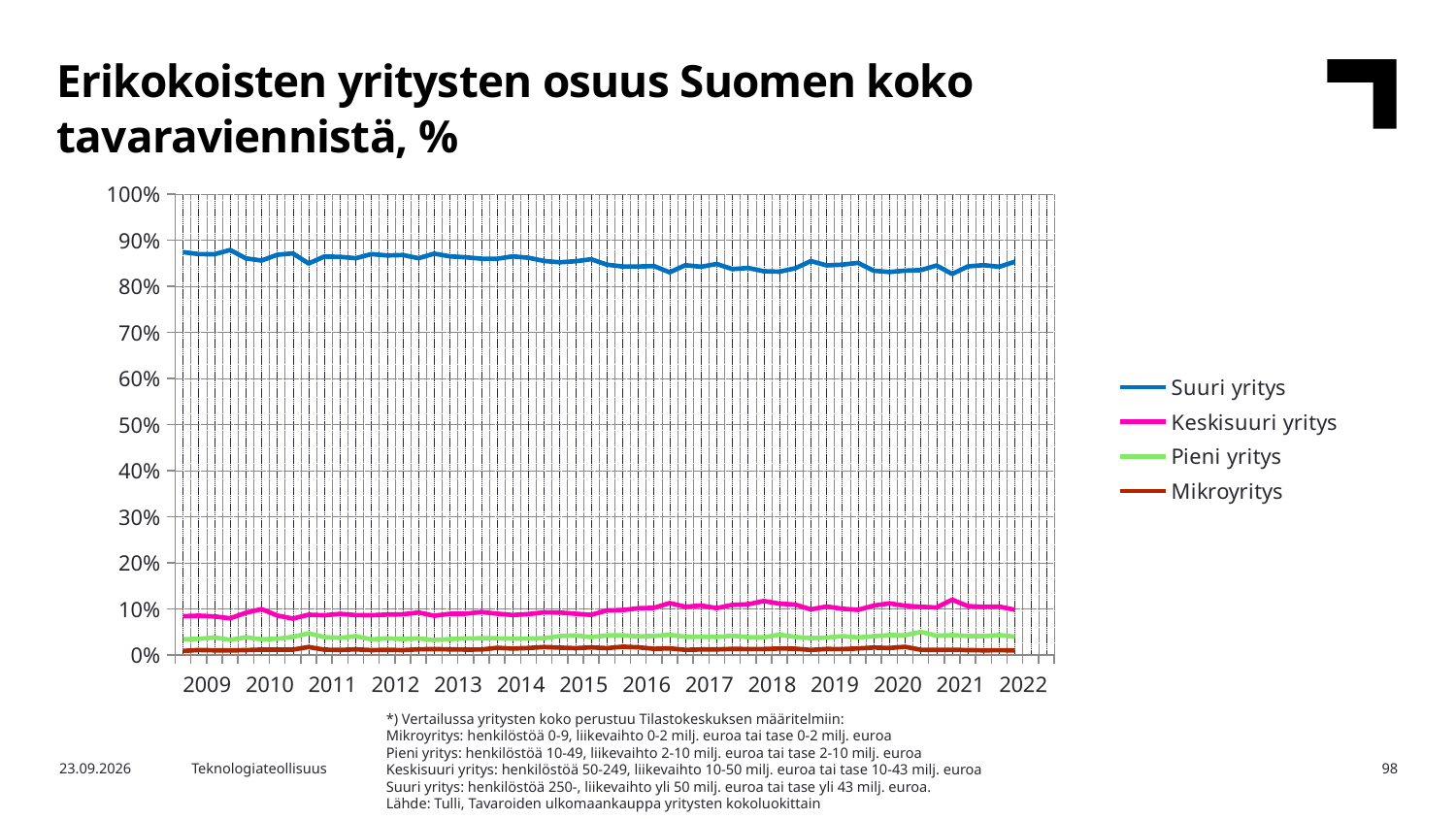
What kind of chart is shown on the slide? Line chart What colour is the line for Keskisuuri yritys? Magenta (pink) How many years are labelled on the x axis? 14 Is the value for Suuri yritys in 2009 greater or less than 90%? less Which is larger in 2020, the value for Pieni yritys or the value for Mikroyritys? Pieni yritys Which is larger in 2018, the value for Suuri yritys or the value for Keskisuuri yritys? Suuri yritys Is the value for Keskisuuri yritys in 2022 greater or less than 20%? less Which series has the highest values throughout the chart? Suuri yritys Is the value for Suuri yritys in 2022 greater or less than 80%? greater How many series does the legend list? 4 Which series has the lowest values throughout the chart? Mikroyritys